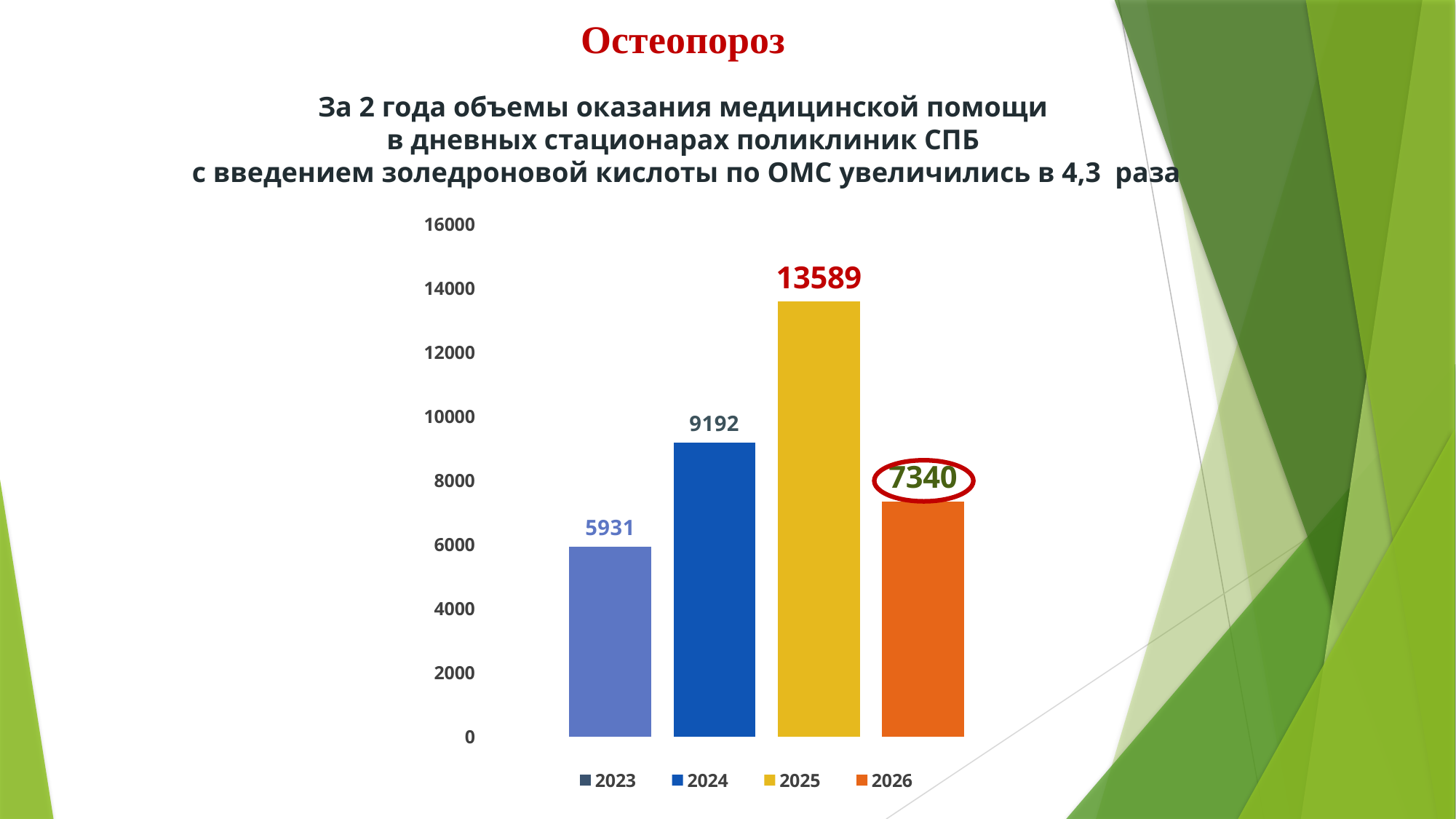
What is the value for 2026? 7340 Which is larger, the value for 2024 or the value for 2026? 2024 What is the value for 2024? 9192 Which year has the lowest value? 2023 What kind of chart is shown on the slide? bar chart How many bars are shown in the chart? 4 What is the difference between the values for 2025 and 2024? 4397 Which year has the highest value? 2025 What is the value for 2023? 5931 How many entries does the legend list? 4 What colour is the bar for 2025? yellow What is the value for 2025? 13589